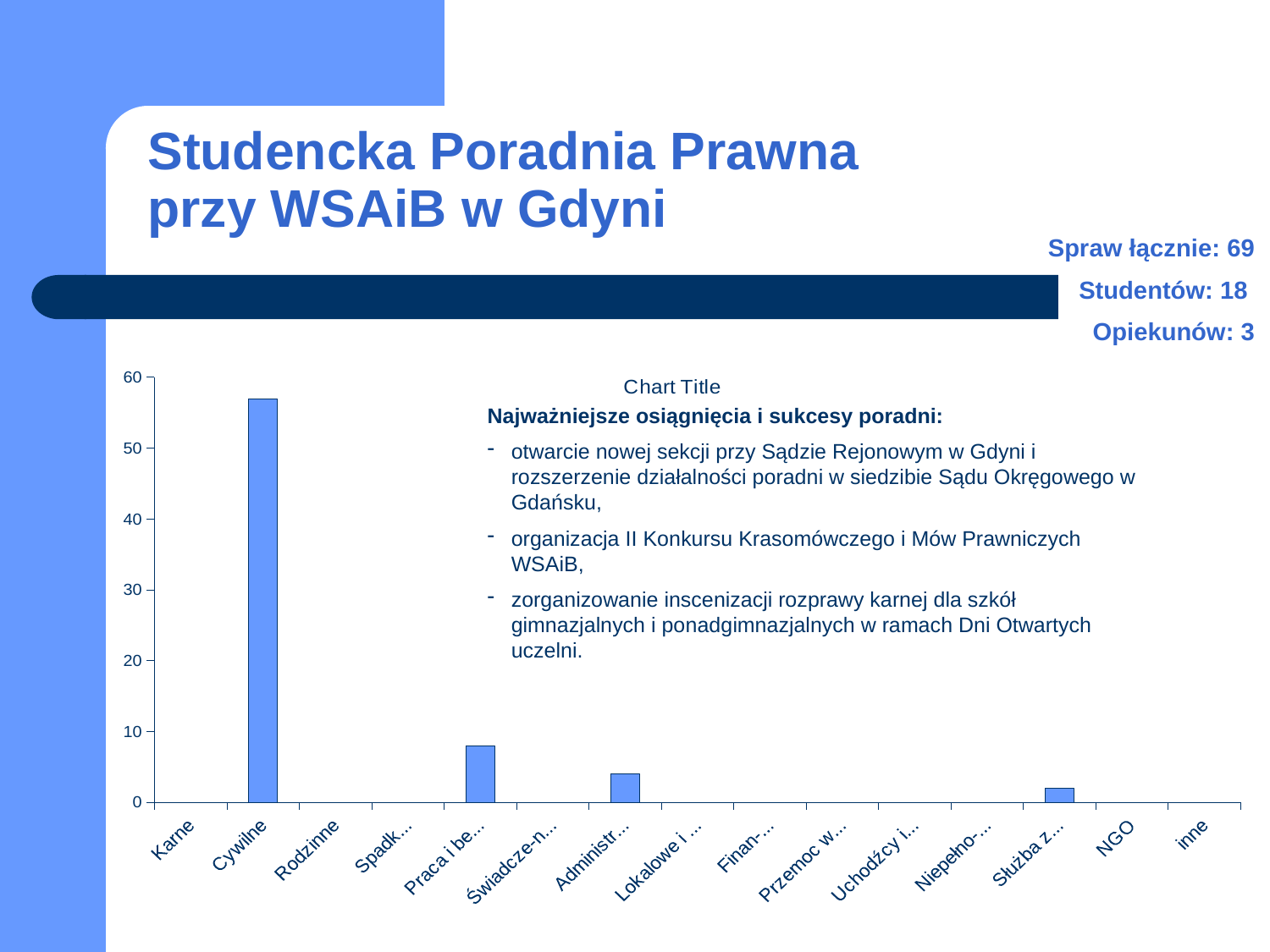
Is the value for Administr... greater or less than 10? less Is the value for Służba z... greater or less than 10? less Which category has the highest bar in the chart? Cywilne How many categories are shown on the x axis of the chart? 15 What is the title shown on the chart? Chart Title Is the value for Praca i be... greater or less than 10? less Which is larger, the value for Cywilne or the value for Praca i be...? Cywilne Which is larger, the value for Administr... or the value for Służba z...? Administr... What kind of chart is shown on the slide? bar chart Which is larger, the value for Praca i be... or the value for Administr...? Praca i be...